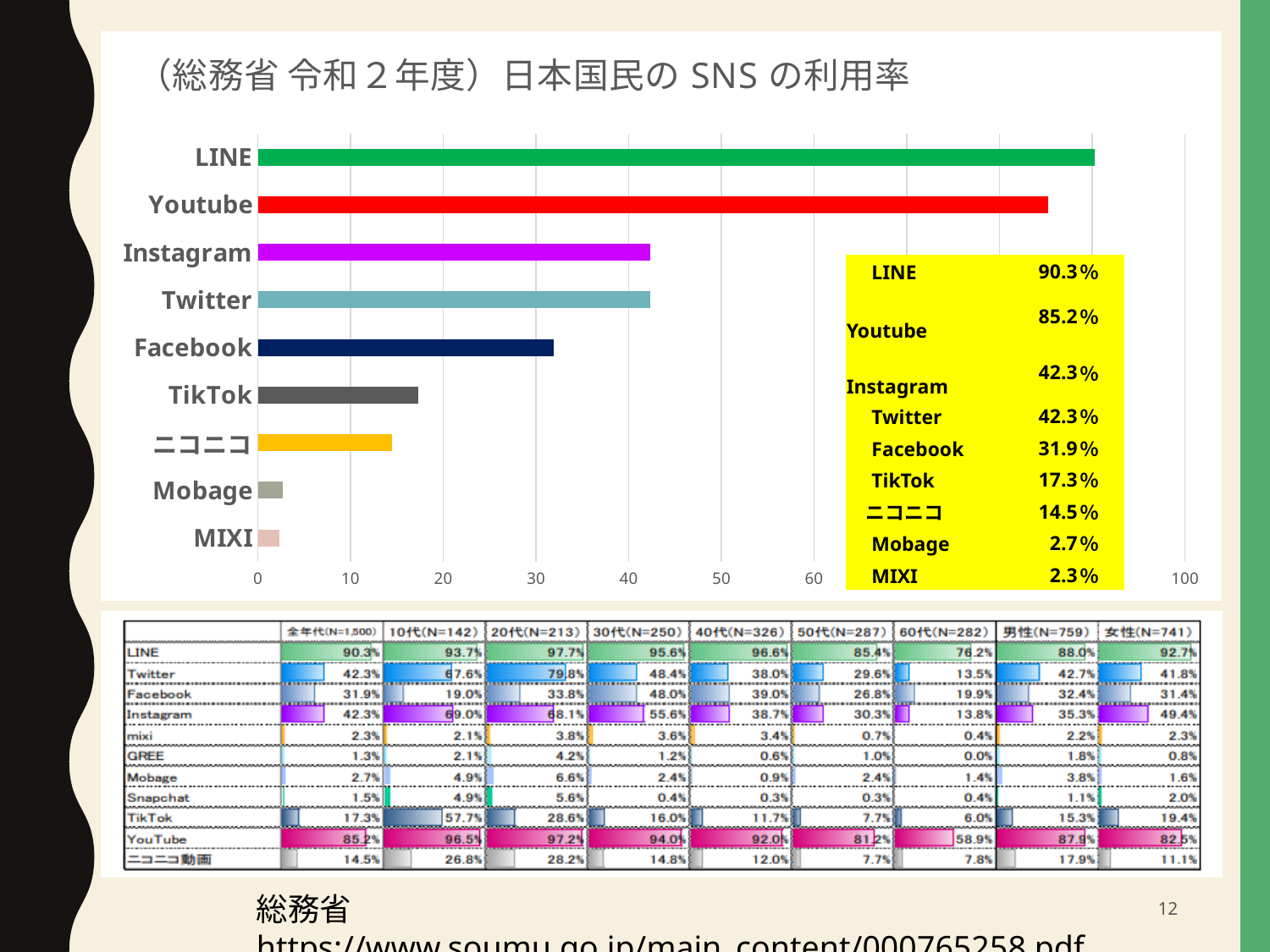
Is the value for Youtube greater or less than 80? greater What is the usage rate for LINE in the bar chart? 90.3% How many SNS services are plotted in the bar chart? 9 Which SNS service has the lowest usage rate in the bar chart? MIXI Which SNS service has the highest usage rate in the bar chart? LINE What type of chart is shown on the slide? bar chart What is the usage rate for Facebook in the bar chart? 31.9% Which has a higher usage rate, Facebook or TikTok? Facebook What is the difference between the usage rates of LINE and Youtube? 5.1% What is the difference between the usage rates of Instagram and Facebook? 10.4% What is the usage rate for ニコニコ in the bar chart? 14.5% What is the usage rate for TikTok in the bar chart? 17.3%